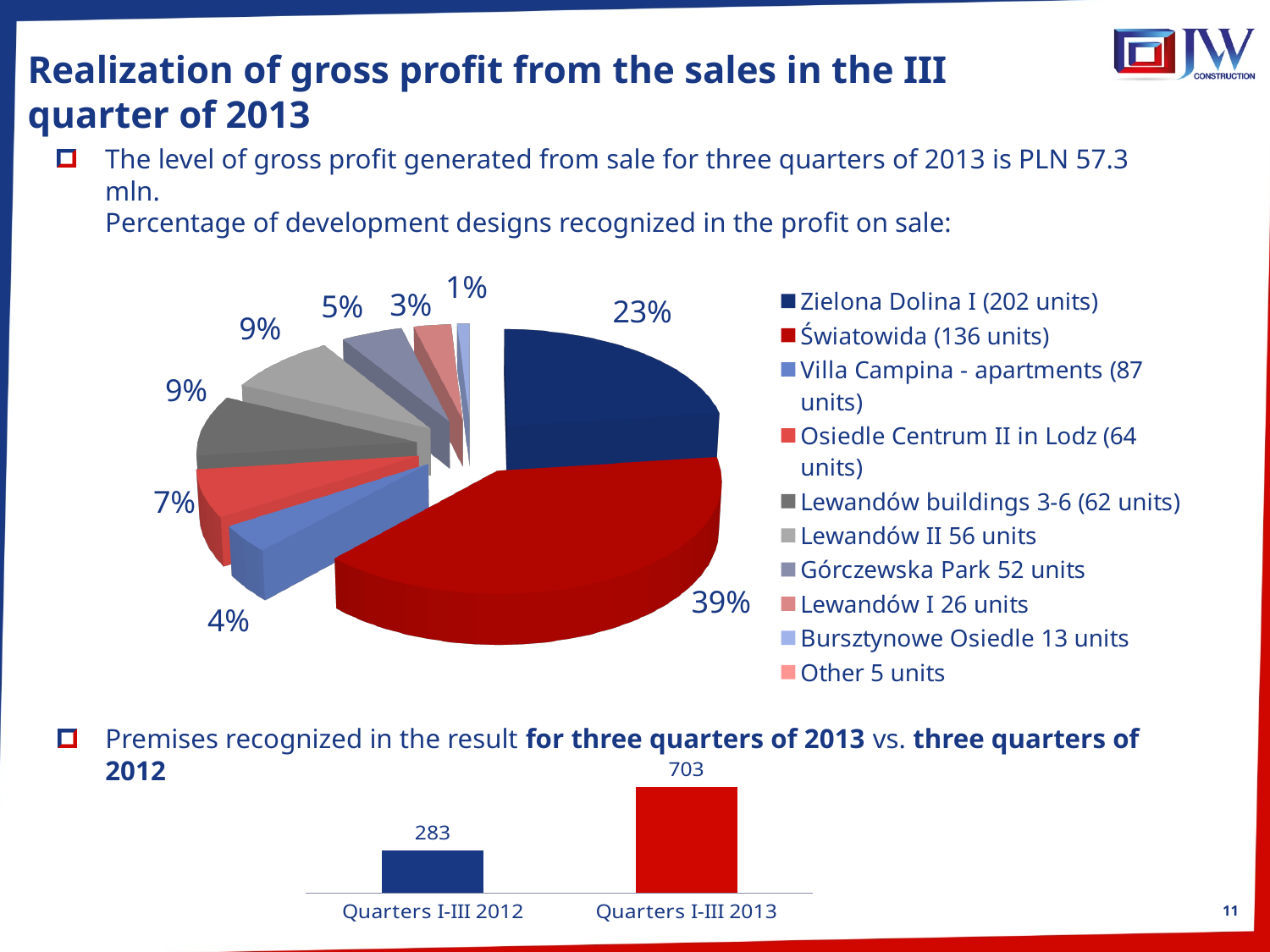
On the pie chart, what is the smallest labelled share shown? 1% On the pie chart, which is larger: the share for Światowida or the share for Zielona Dolina I? Światowida On the pie chart, what is the difference between the Światowida share and the Zielona Dolina I share? 16 percentage points On the pie chart, how many entries does the legend list? 10 What type of chart is the chart at the bottom of the slide? Bar chart On the bottom bar chart, how many categories are shown? 2 On the bottom bar chart, how many premises were recognized in the result for Quarters I-III 2013? 703 On the bottom bar chart, how many premises were recognized in the result for Quarters I-III 2012? 283 On the pie chart, what share is attributed to Zielona Dolina I (202 units)? 23% On the pie chart, which development has the largest share? Światowida (136 units) On the bottom bar chart, what is the difference between the 2013 and 2012 values? 420 On the pie chart, what share of the profit on sale is attributed to Światowida (136 units)? 39%